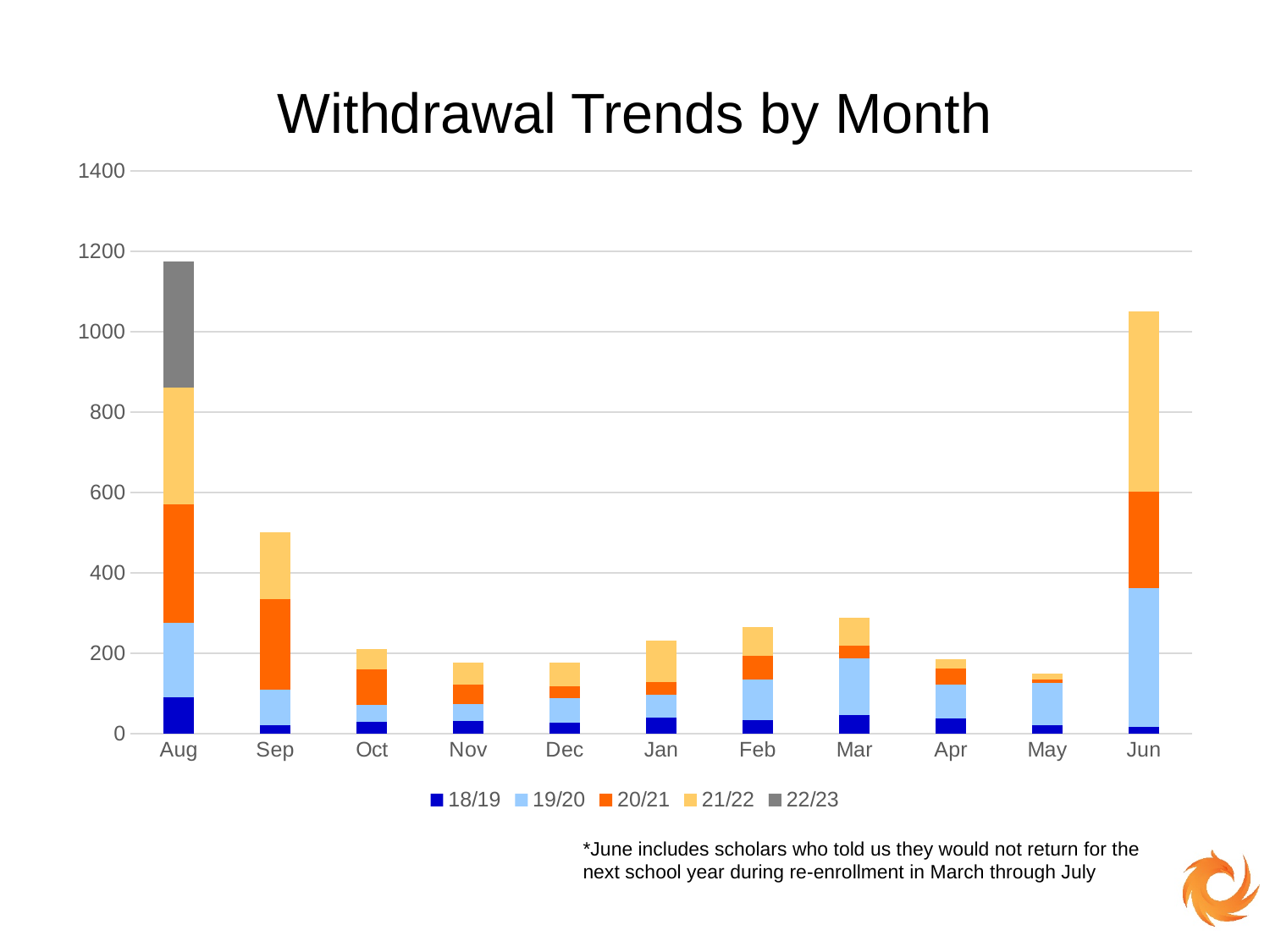
Is the total stacked value for Jun greater or less than 1000? greater Which series in the legend is shown in grey? 22/23 Which month has a taller stacked bar, Sep or Oct? Sep Which month has a taller stacked bar, Jun or Sep? Jun What is the title of the chart? Withdrawal Trends by Month How many months are shown on the x axis of the chart? 11 How many series does the legend list? 5 Which month has the shortest stacked bar? May Which month has the tallest stacked bar? Aug Is the total stacked value for Mar greater or less than 400? less Is the total stacked value for Aug greater or less than 1000? greater What type of chart is shown on the slide? stacked bar chart